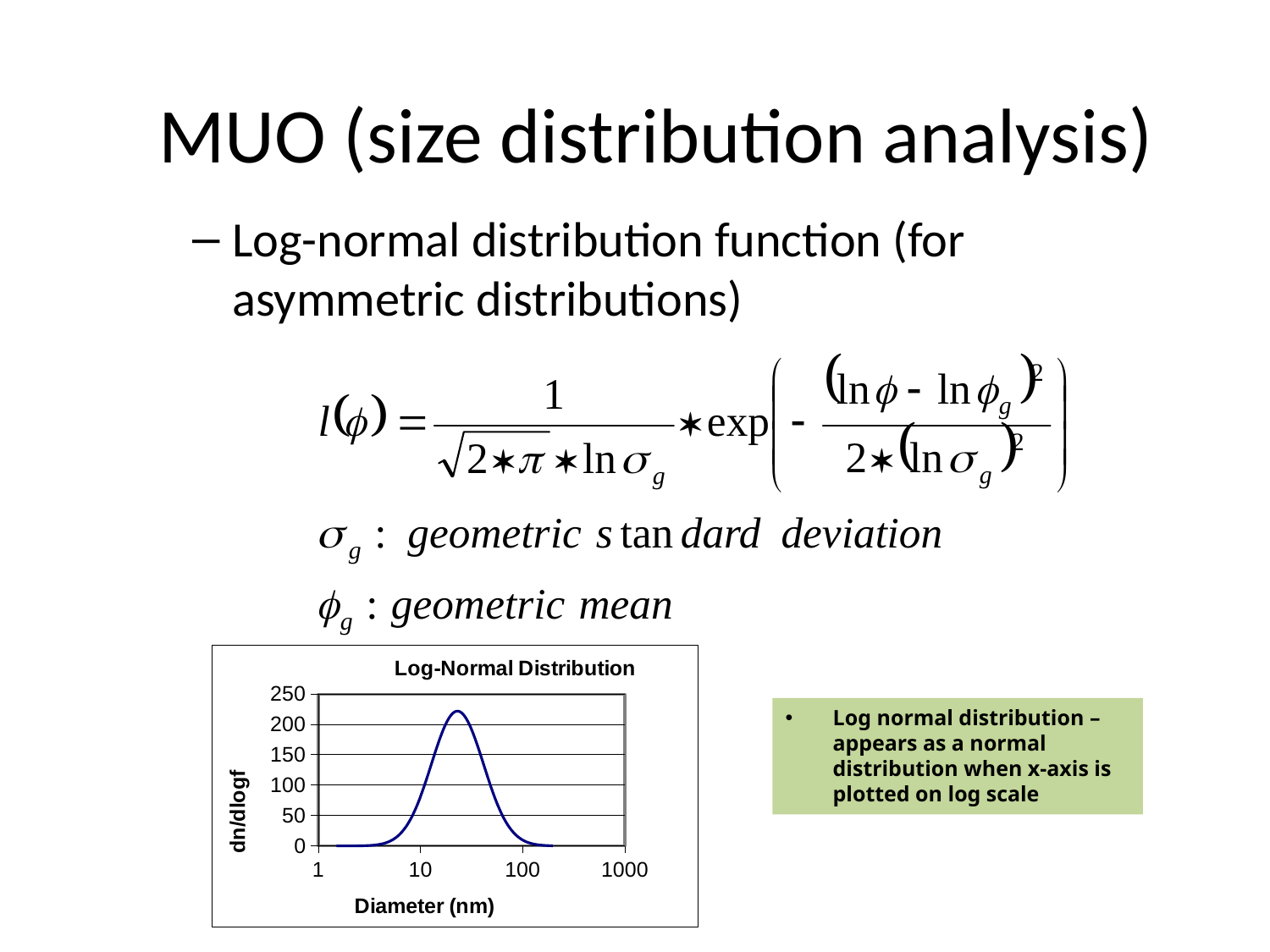
How many tick labels are shown on the x axis of the Log-Normal Distribution chart? 4 What kind of chart is the Log-Normal Distribution chart? line chart What is the title of the chart on the slide? Log-Normal Distribution In the Log-Normal Distribution chart, does the curve rise or fall as the diameter increases from 10 nm to 100 nm? rises then falls In the Log-Normal Distribution chart, is the peak value of the curve greater or less than 250? less In the Log-Normal Distribution chart, is the value of the curve at a diameter of 10 nm greater or less than 50? greater What is the label of the x axis of the Log-Normal Distribution chart? Diameter (nm) What is the highest tick value shown on the y axis of the Log-Normal Distribution chart? 250 In the Log-Normal Distribution chart, is the peak value of the curve greater or less than 200? greater In the Log-Normal Distribution chart, is the curve value at 10 nm larger or smaller than the value at 100 nm? larger In the Log-Normal Distribution chart, does the curve rise or fall as the diameter increases from 100 nm to 1000 nm? falls